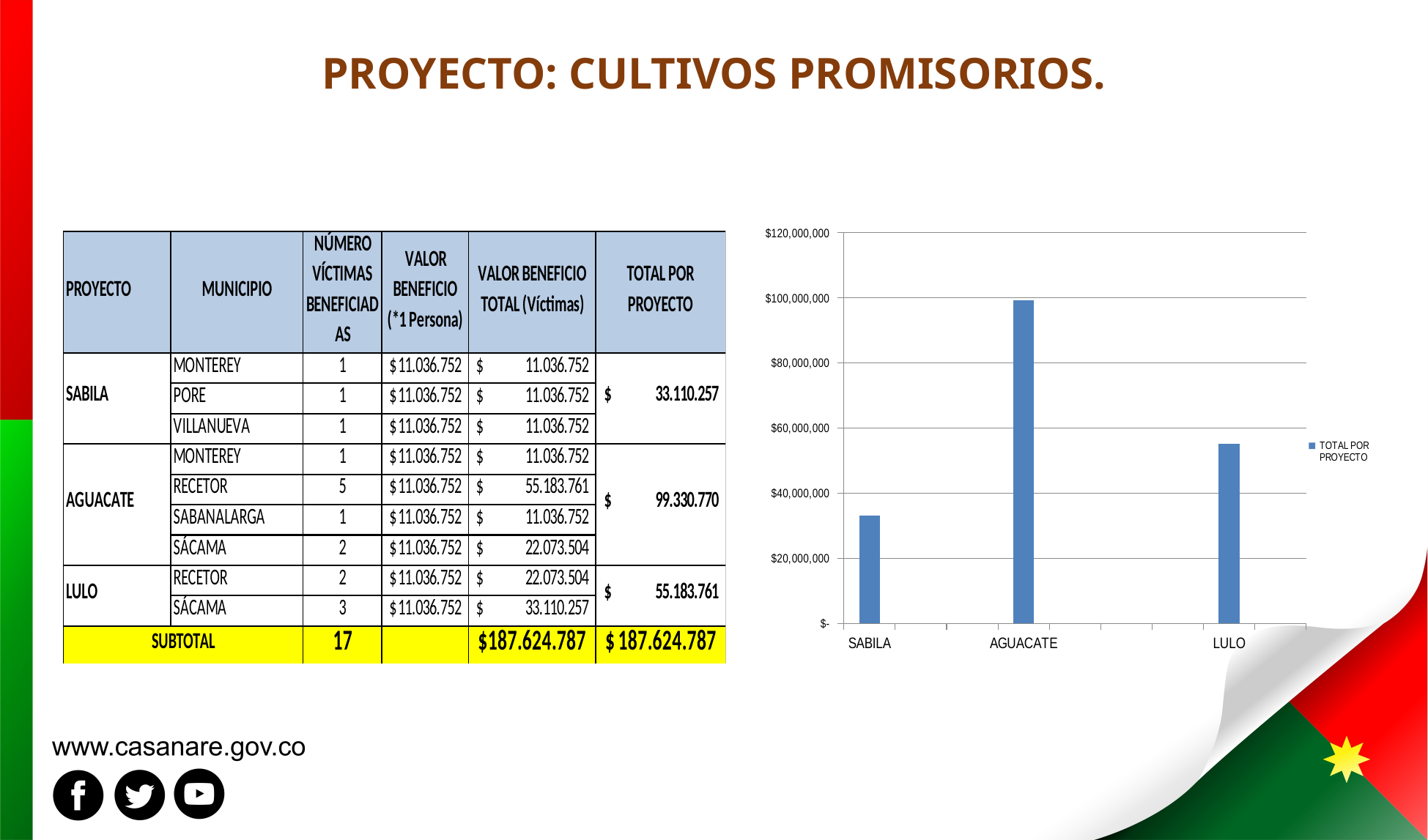
Which is larger in the chart, the bar for LULO or the bar for SABILA? LULO Is the bar for AGUACATE greater or less than $80,000,000? greater What is the highest value shown on the chart's vertical axis? $120,000,000 What kind of chart is shown on the right of the slide? bar chart Is the bar for SABILA greater or less than $40,000,000? less How many series does the chart legend list? 1 What is the name of the series in the chart legend? TOTAL POR PROYECTO Is the bar for LULO greater or less than $40,000,000? greater Which category has the highest bar in the chart? AGUACATE How many categories are shown on the x axis of the chart? 3 Which category has the lowest bar in the chart? SABILA